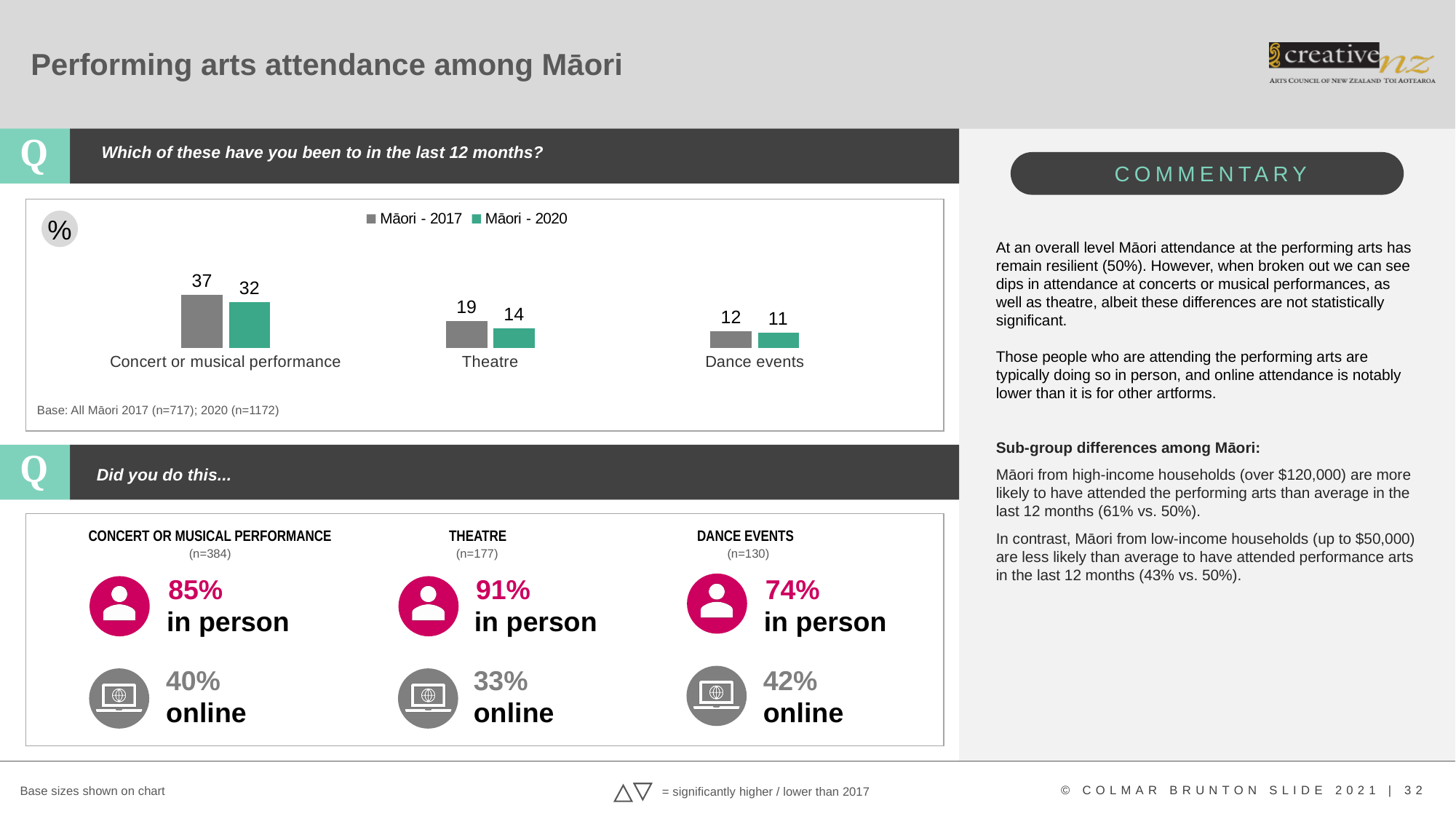
How many categories are shown on the bar chart? 3 What is the value for Māori - 2020 for Dance events? 11 What is the difference between the Māori - 2017 and Māori - 2020 values for Concert or musical performance? 5 Which category has the lowest value for Māori - 2017? Dance events What is the difference between the Māori - 2017 and Māori - 2020 values for Theatre? 5 Which category has the highest value for Māori - 2020? Concert or musical performance What kind of chart is used to show attendance by category? Bar chart How many series does the legend of the bar chart list? 2 What is the value for Māori - 2017 for Concert or musical performance? 37 What is the value for Māori - 2020 for Theatre? 14 Which is larger for Dance events: the Māori - 2017 value or the Māori - 2020 value? Māori - 2017 Which colour represents the Māori - 2020 series in the bar chart? Green